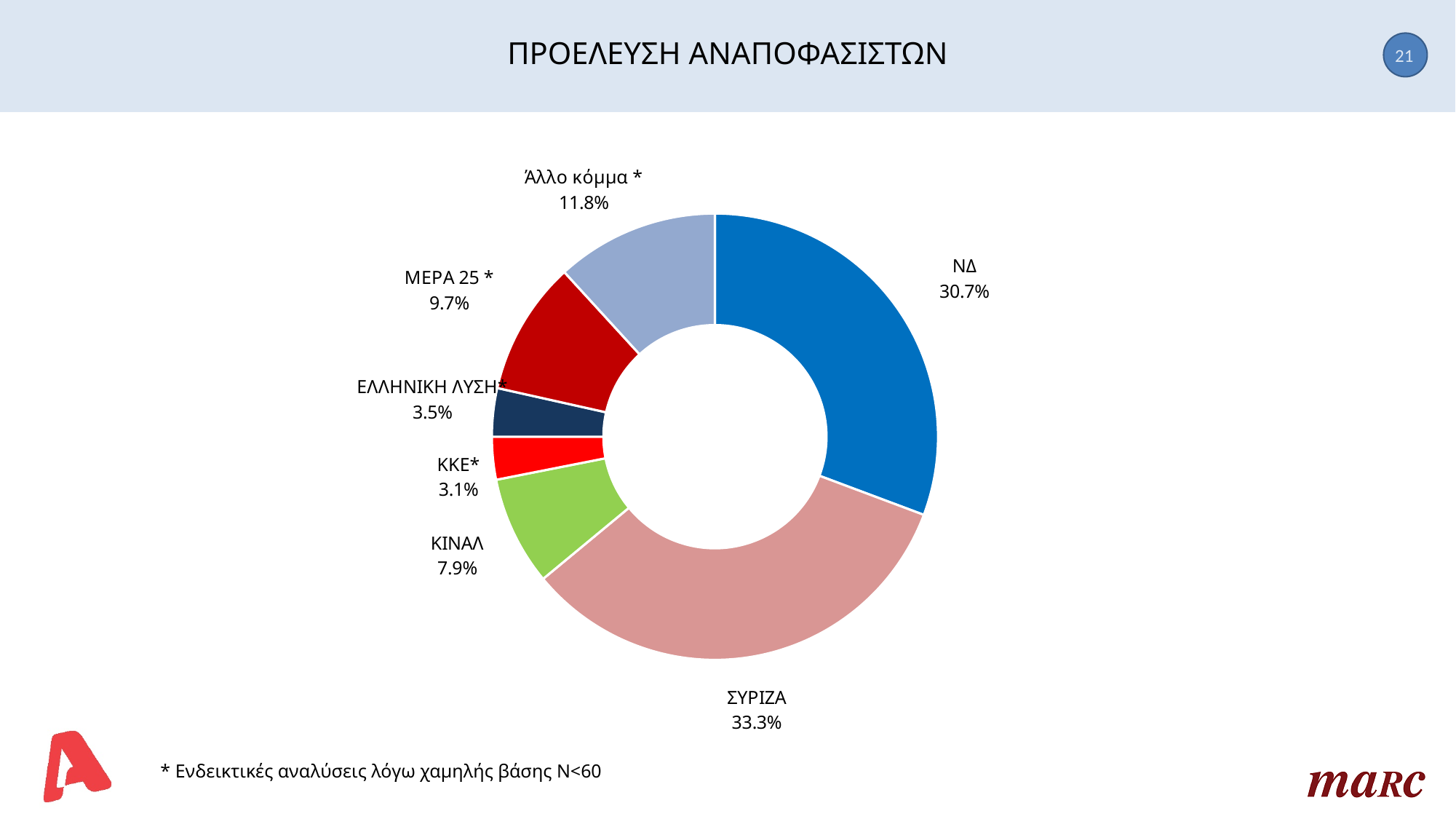
Which category has the smallest share? ΚΚΕ What type of chart is shown on the slide? Pie (donut) chart What is the share for ΜΕΡΑ 25? 9.7% What is the share for Άλλο κόμμα? 11.8% How many categories are shown in the chart? 7 Which category has the largest share? ΣΥΡΙΖΑ What is the share for ΝΔ? 30.7% What is the share for ΚΙΝΑΛ? 7.9% What is the title of the slide? ΠΡΟΕΛΕΥΣΗ ΑΝΑΠΟΦΑΣΙΣΤΩΝ What is the share for ΣΥΡΙΖΑ? 33.3% Which has a larger share, ΜΕΡΑ 25 or ΚΙΝΑΛ? ΜΕΡΑ 25 What is the difference between the shares of ΣΥΡΙΖΑ and ΝΔ? 2.6%